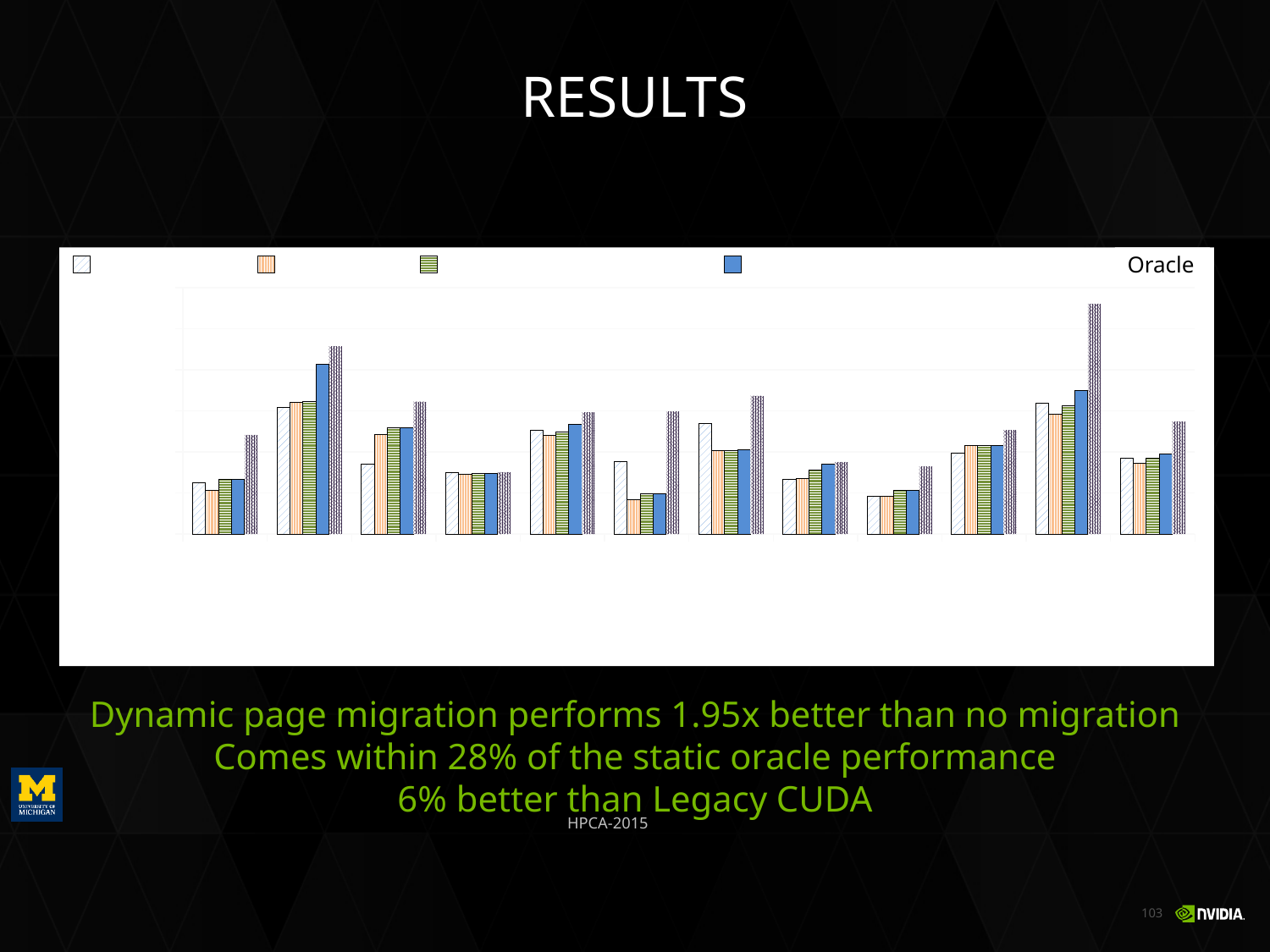
Which series has the tallest bar in the eleventh group from the left? Oracle How many bars are drawn in each group of the chart? 5 What kind of chart is shown on the slide? bar chart How many series does the chart's legend list? 5 How many groups of bars (categories) are plotted in the chart? 12 Which legend entry in the chart has a readable text label? Oracle